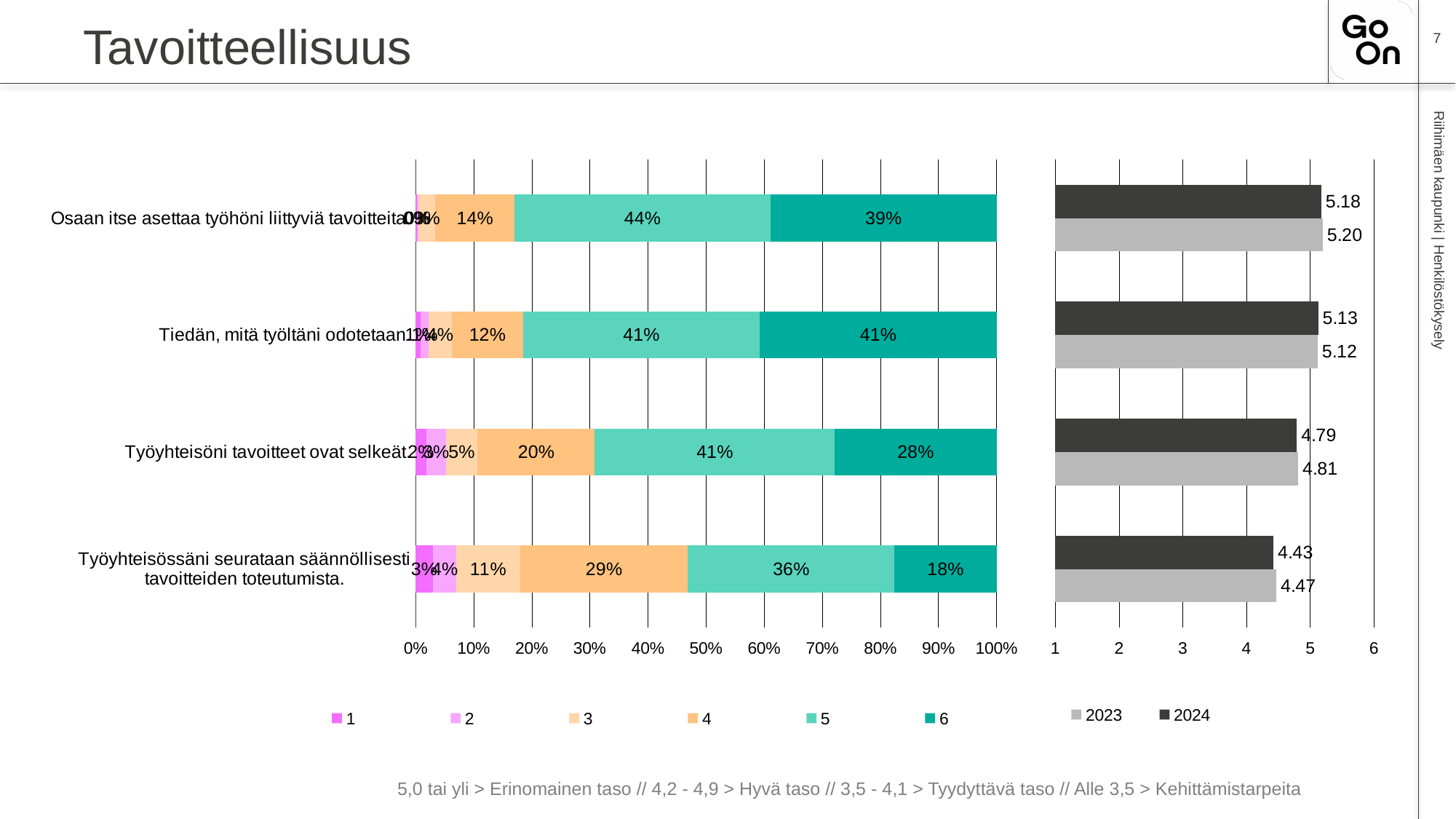
In the right-hand chart, what is the 2024 value for "Osaan itse asettaa työhöni liittyviä tavoitteita"? 5.18 In the left-hand stacked chart, which statement has the largest share of 6 responses? Tiedän, mitä työltäni odotetaan How many series does the legend of the left-hand chart list? 6 In the right-hand chart, which statement has the lowest 2024 value? Työyhteisössäni seurataan säännöllisesti tavoitteiden toteutumista In the left-hand stacked chart, what percentage of respondents gave a 4 for "Työyhteisössäni seurataan säännöllisesti tavoitteiden toteutumista"? 29% In the left-hand stacked chart, what percentage of respondents gave a 6 for "Tiedän, mitä työltäni odotetaan"? 41% In the left-hand stacked chart, which has a larger share of 5 responses: "Osaan itse asettaa työhöni liittyviä tavoitteita" or "Työyhteisössäni seurataan säännöllisesti tavoitteiden toteutumista"? Osaan itse asettaa työhöni liittyviä tavoitteita In the right-hand chart, what is the difference between the 2023 and 2024 values for "Työyhteisöni tavoitteet ovat selkeät"? 0.02 How many series does the legend of the right-hand chart list? 2 What kind of chart is the left-hand chart? Stacked bar chart In the right-hand chart, what is the 2023 value for "Työyhteisössäni seurataan säännöllisesti tavoitteiden toteutumista"? 4.47 In the right-hand chart, which statement has the highest 2023 value? Osaan itse asettaa työhöni liittyviä tavoitteita